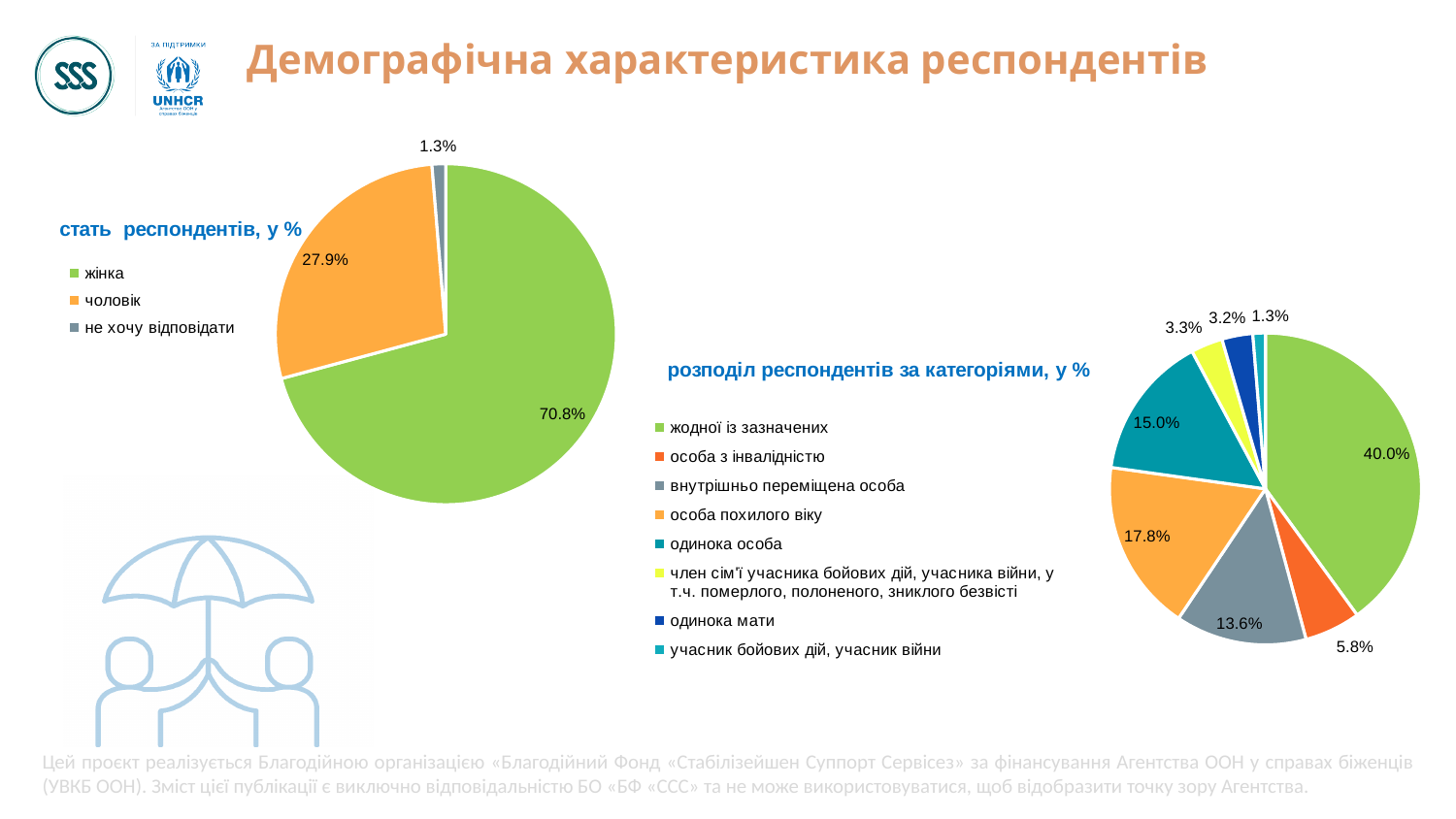
In the chart 'розподіл респондентів за категоріями, у %', what is the value for одинока мати? 3.2% In the chart 'розподіл респондентів за категоріями, у %', which is larger: одинока особа or особа з інвалідністю? одинока особа In the chart 'розподіл респондентів за категоріями, у %', which category has the smallest share? учасник бойових дій, учасник війни In the chart 'стать респондентів, у %', which category has the smallest share? не хочу відповідати In the chart 'розподіл респондентів за категоріями, у %', what is the value for внутрішньо переміщена особа? 13.6% In the chart 'стать респондентів, у %', what is the value for чоловік? 27.9% How many categories does the legend of 'розподіл респондентів за категоріями, у %' list? 8 What kind of chart is 'розподіл респондентів за категоріями, у %'? pie chart In the chart 'стать респондентів, у %', what is the value for жінка? 70.8% In the chart 'стать респондентів, у %', what is the difference between the values for жінка and чоловік? 42.9% In the chart 'розподіл респондентів за категоріями, у %', which category has the largest share? жодної із зазначених In the chart 'розподіл респондентів за категоріями, у %', what is the value for особа похилого віку? 17.8%